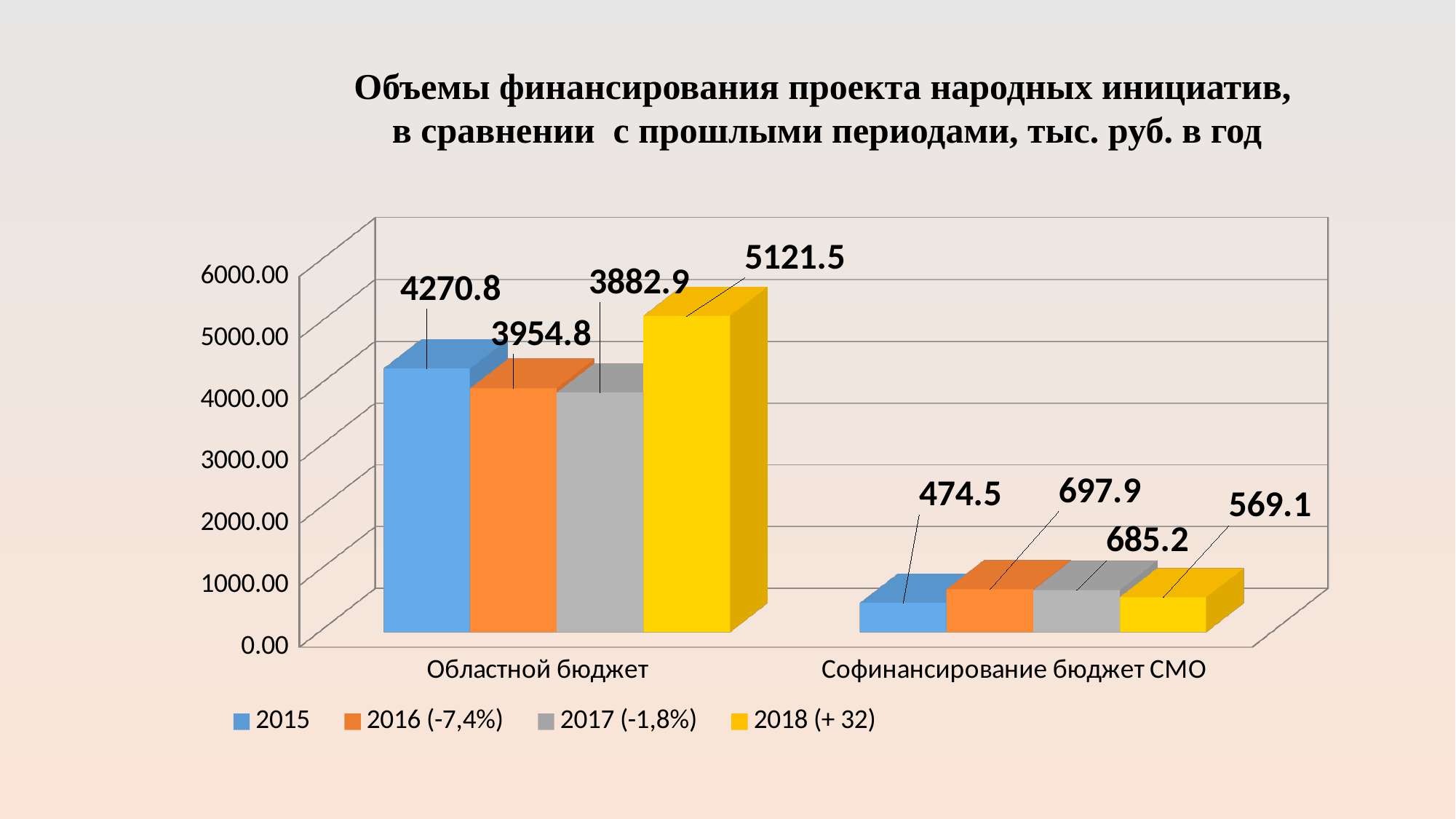
Which is larger in the Софинансирование бюджет СМО category: the 2016 (-7,4%) value or the 2018 (+ 32) value? 2016 (-7,4%) Is the 2015 value for Областной бюджет greater or less than 4000.00? greater What is the value for 2016 (-7,4%) in the Софинансирование бюджет СМО category? 697.9 How many categories are shown on the x axis? 2 What is the difference between the 2018 (+ 32) and 2015 values in the Областной бюджет category? 850.7 What kind of chart is shown on the slide? Bar chart Which year has the lowest value in the Софинансирование бюджет СМО category? 2015 What is the value for 2017 (-1,8%) in the Софинансирование бюджет СМО category? 685.2 Which year has the highest value in the Областной бюджет category? 2018 (+ 32) What is the value for 2018 (+ 32) in the Областной бюджет category? 5121.5 What is the value for 2015 in the Областной бюджет category? 4270.8 How many series does the legend list? 4